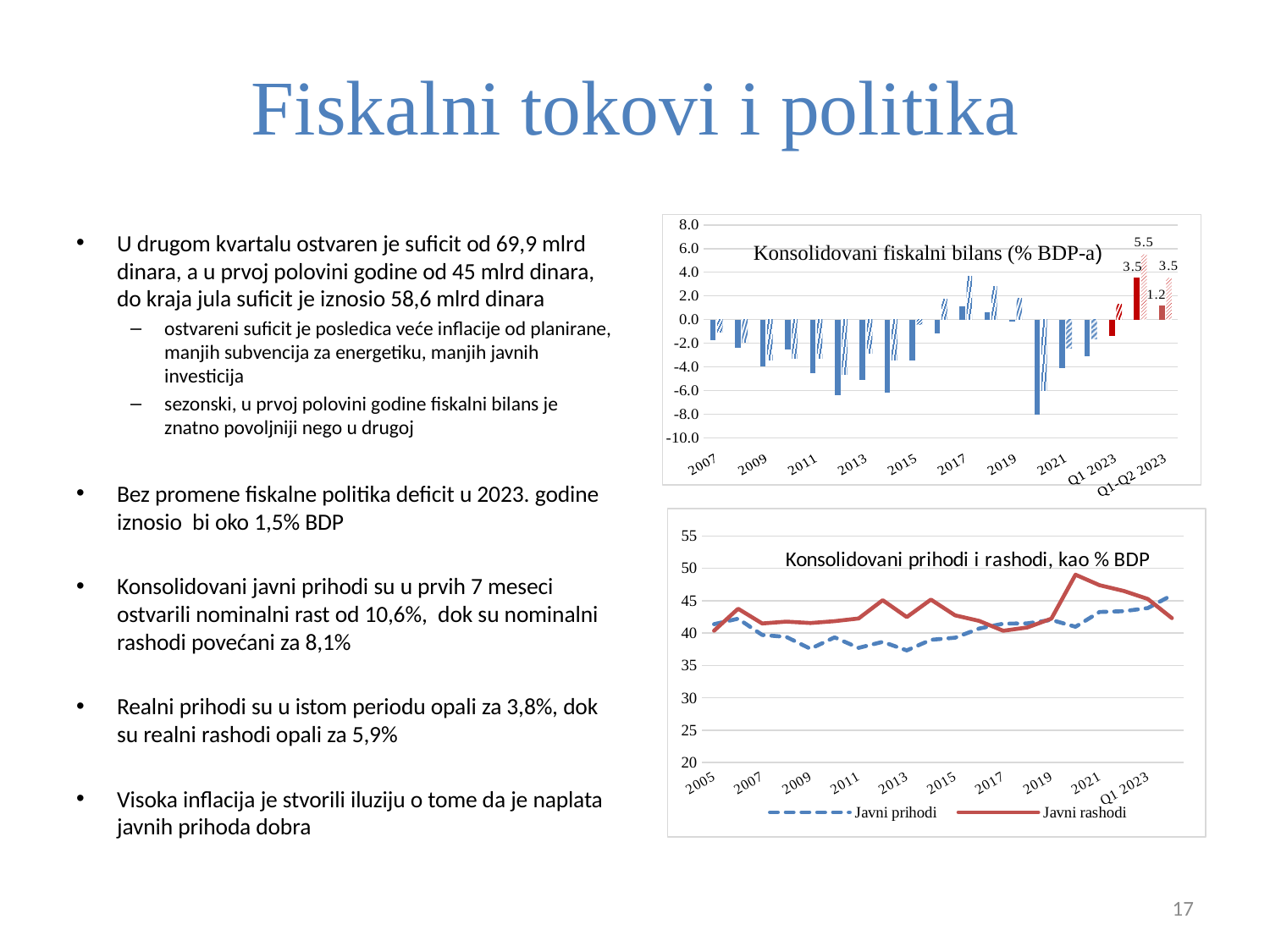
In the 'Konsolidovani fiskalni bilans (% BDP-a)' chart, is the value for 2017 greater or less than 0.0? greater In the 'Konsolidovani prihodi i rashodi, kao % BDP' chart, does Javni rashodi rise or fall from 2020 to Q1 2023? fall What kind of chart is the 'Konsolidovani prihodi i rashodi, kao % BDP' chart? line chart In the 'Konsolidovani prihodi i rashodi, kao % BDP' chart, is the value of Javni rashodi in 2020 greater or less than 45? greater In the 'Konsolidovani fiskalni bilans (% BDP-a)' chart, which year has the lowest value? 2020 In the 'Konsolidovani fiskalni bilans (% BDP-a)' chart, is the value for 2012 greater or less than -4.0? less In the 'Konsolidovani prihodi i rashodi, kao % BDP' chart, which series has the higher value in 2020, Javni prihodi or Javni rashodi? Javni rashodi In the 'Konsolidovani prihodi i rashodi, kao % BDP' chart, which series is drawn with a dashed line? Javni prihodi What kind of chart is the 'Konsolidovani fiskalni bilans (% BDP-a)' chart? bar chart How many series does the legend of the 'Konsolidovani prihodi i rashodi, kao % BDP' chart list? 2